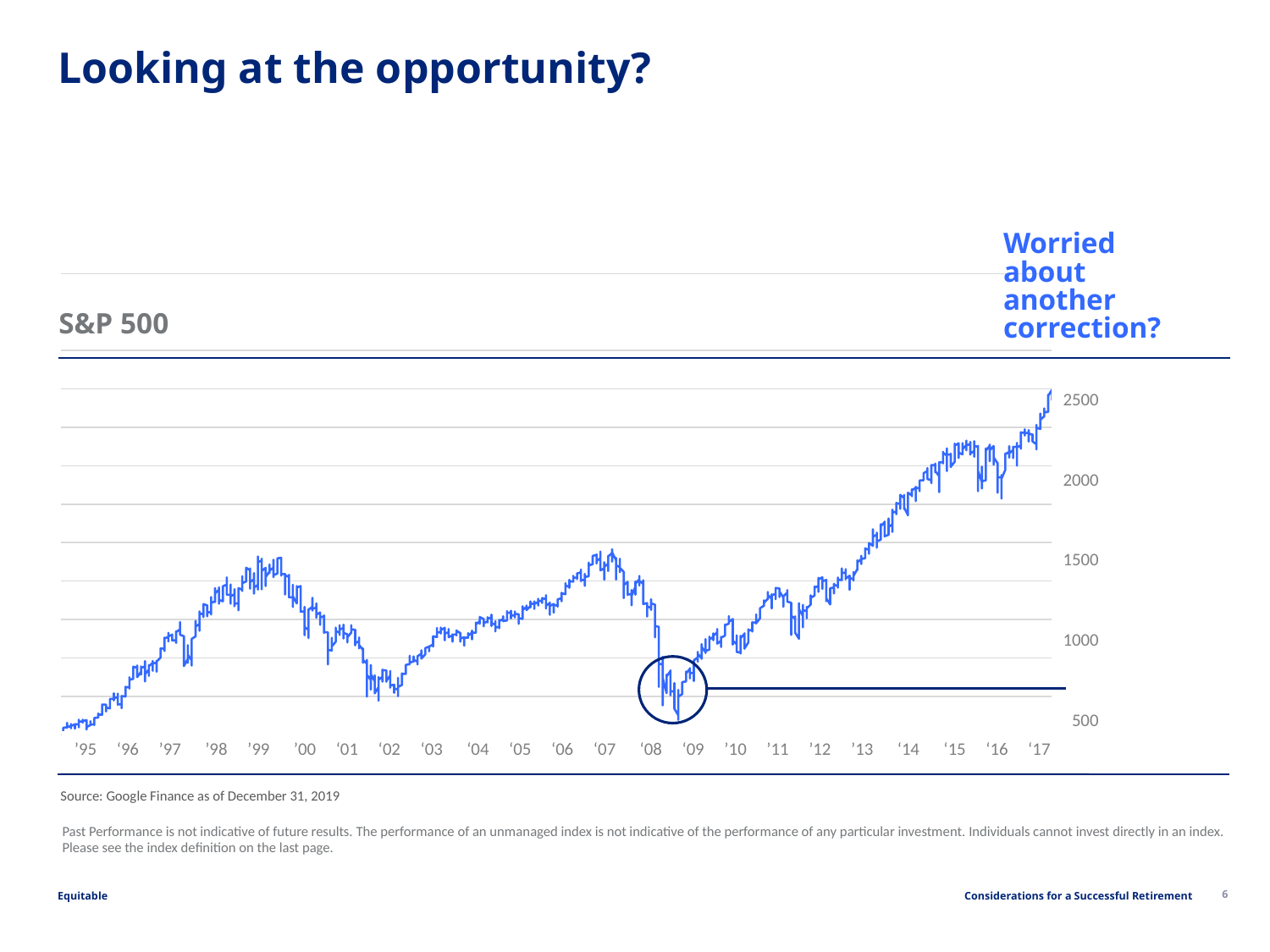
What is the title of the chart? S&P 500 What is the highest value labelled on the y axis of the chart? 2500 Is the value of the S&P 500 at the end of '17 greater or less than 2000? greater Is the peak value of the S&P 500 around '00 greater or less than 1000? greater Is the lowest value of the S&P 500 around '09 greater or less than 1000? less Which is larger, the S&P 500 value at the end of '17 or at the start of '95? end of '17 How many year labels are shown along the x axis of the chart? 23 Does the S&P 500 line rise or fall between '09 and '17? rise What kind of chart is shown on the slide? line chart Overall, does the S&P 500 line rise or fall from '95 to '17? rise Does the S&P 500 line rise or fall between '07 and '09? fall